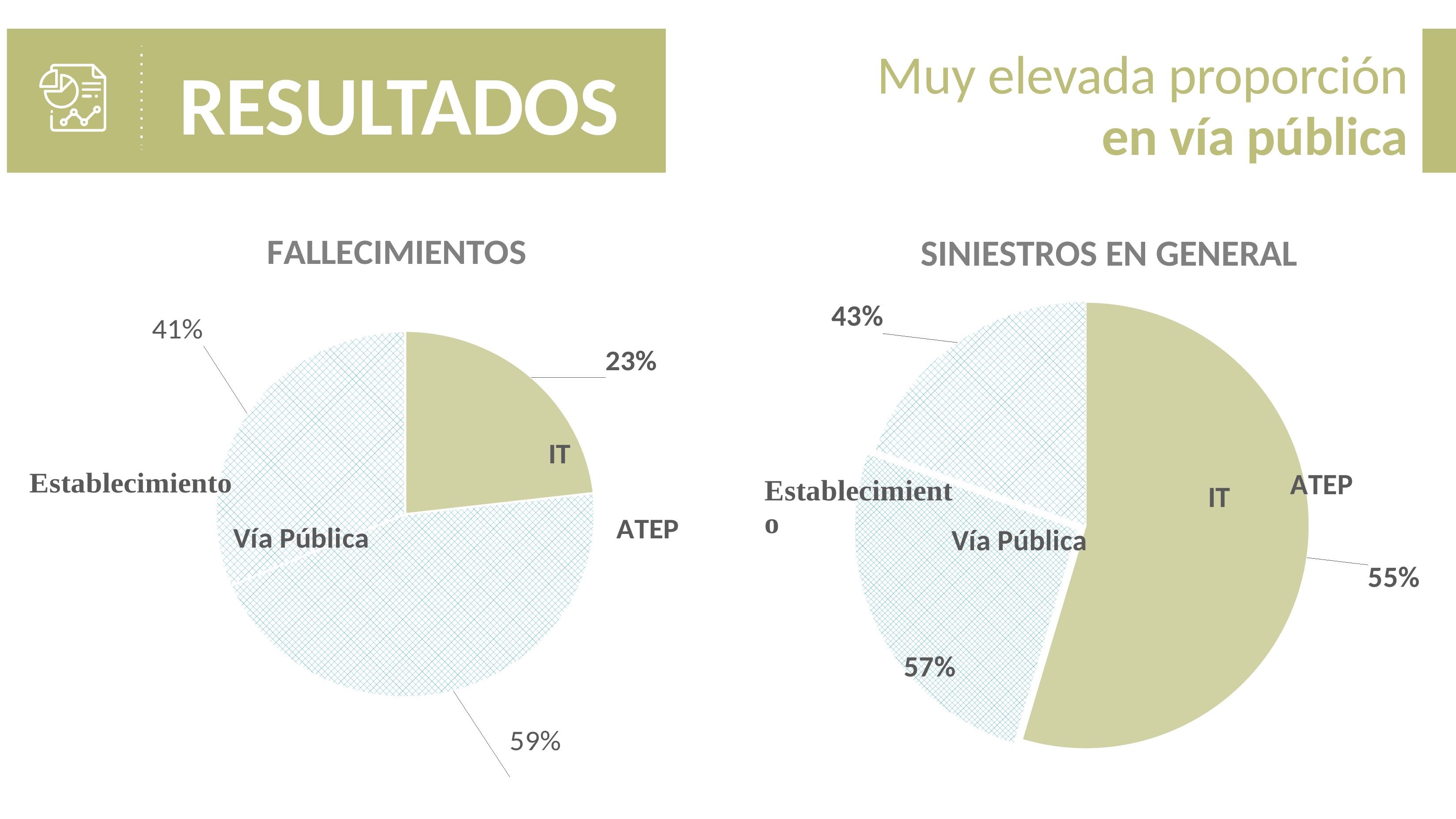
In the FALLECIMIENTOS chart, what percentage is shown for IT? 23% In the FALLECIMIENTOS chart, which is larger, Vía Pública or Establecimiento? Vía Pública In the SINIESTROS EN GENERAL chart, what percentage is shown for Vía Pública? 57% What kind of chart is the FALLECIMIENTOS chart? Pie chart In the FALLECIMIENTOS chart, what percentage is shown for Establecimiento? 41% In the SINIESTROS EN GENERAL chart, which is larger, Vía Pública or Establecimiento? Vía Pública In the SINIESTROS EN GENERAL chart, which is larger, IT or Establecimiento? IT How many charts are shown on the slide? 2 What is the title of the chart on the right side of the slide? SINIESTROS EN GENERAL In the SINIESTROS EN GENERAL chart, what percentage is shown for IT? 55% In the FALLECIMIENTOS chart, what percentage is shown for Vía Pública? 59% In the SINIESTROS EN GENERAL chart, what percentage is shown for Establecimiento? 43%